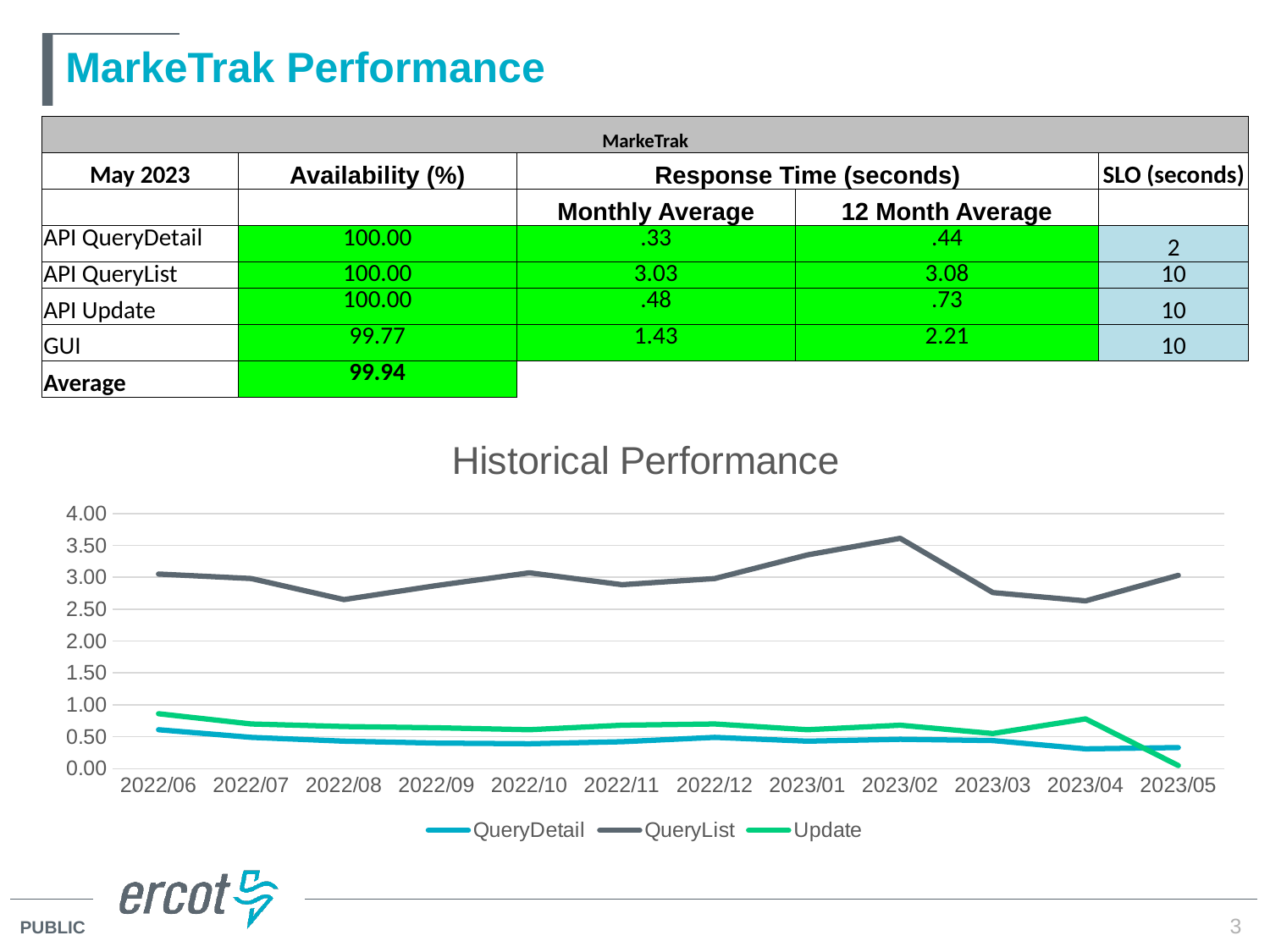
In the Historical Performance chart, is the Update value for 2022/06 greater or less than 0.50? greater In the Historical Performance chart, which is larger at 2022/12: QueryList or Update? QueryList In which month does the Update series reach its lowest point in the Historical Performance chart? 2023/05 In the Historical Performance chart, does the Update series rise or fall from 2023/04 to 2023/05? fall How many series does the legend of the Historical Performance chart list? 3 How many months are plotted along the x axis of the Historical Performance chart? 12 What kind of chart is the Historical Performance chart? line chart In the Historical Performance chart, is the QueryList value for 2022/08 greater or less than 3.00? less In the Historical Performance chart, is the QueryList value for 2023/02 greater or less than 3.00? greater Which series has the highest values throughout the Historical Performance chart? QueryList In which month does the QueryList series reach its highest point in the Historical Performance chart? 2023/02